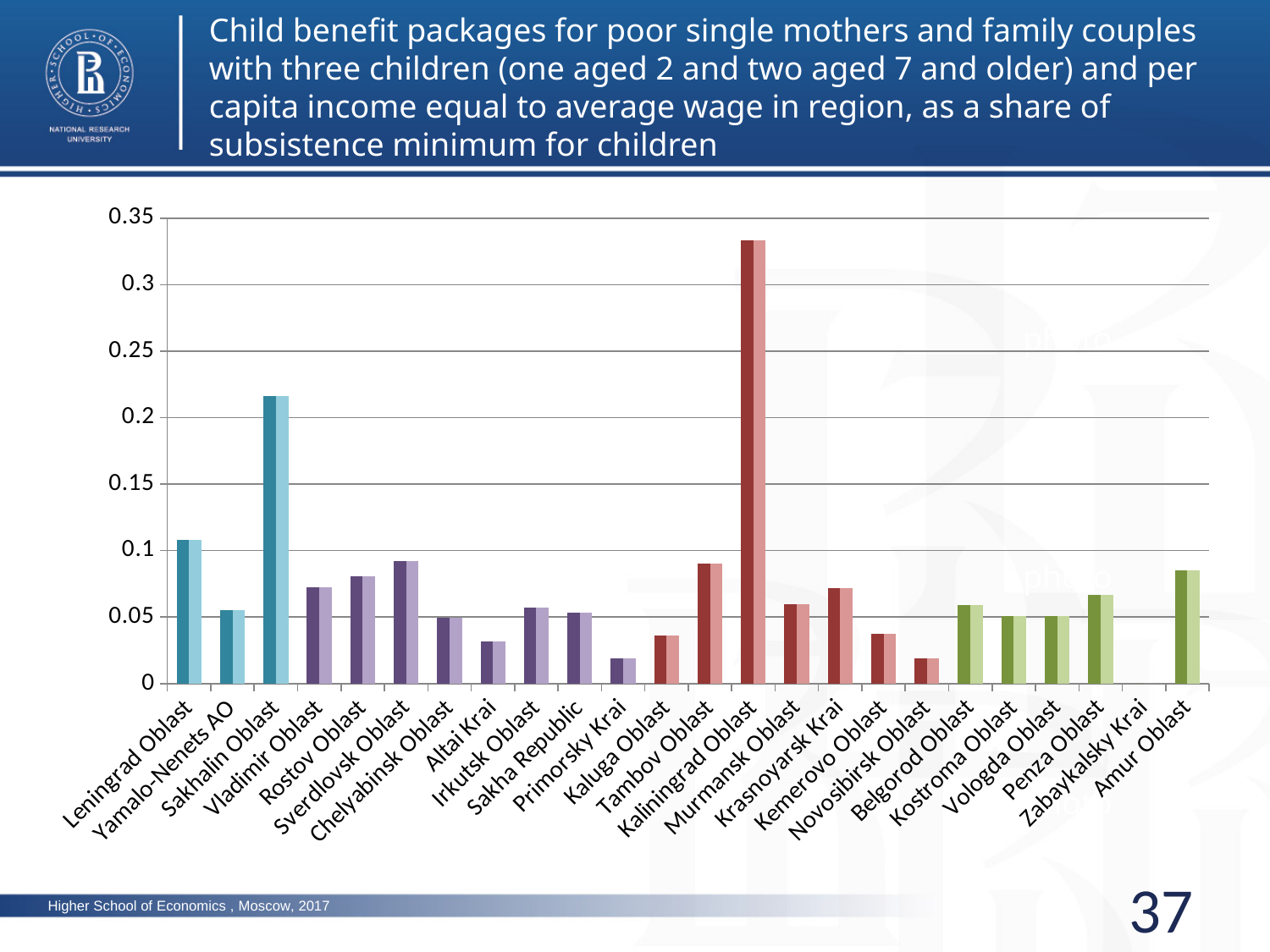
Which region has the highest value in the chart? Kaliningrad Oblast Is the value for Leningrad Oblast greater or less than 0.1? greater How many regions are shown on the x axis of the chart? 24 Is the value for Kaliningrad Oblast greater or less than 0.3? greater Is the value for Tambov Oblast greater or less than 0.1? less What kind of chart is shown on the slide? bar chart Which has the larger value, Tambov Oblast or Kaluga Oblast? Tambov Oblast Which has the larger value, Sverdlovsk Oblast or Altai Krai? Sverdlovsk Oblast Which has the larger value, Sakhalin Oblast or Leningrad Oblast? Sakhalin Oblast